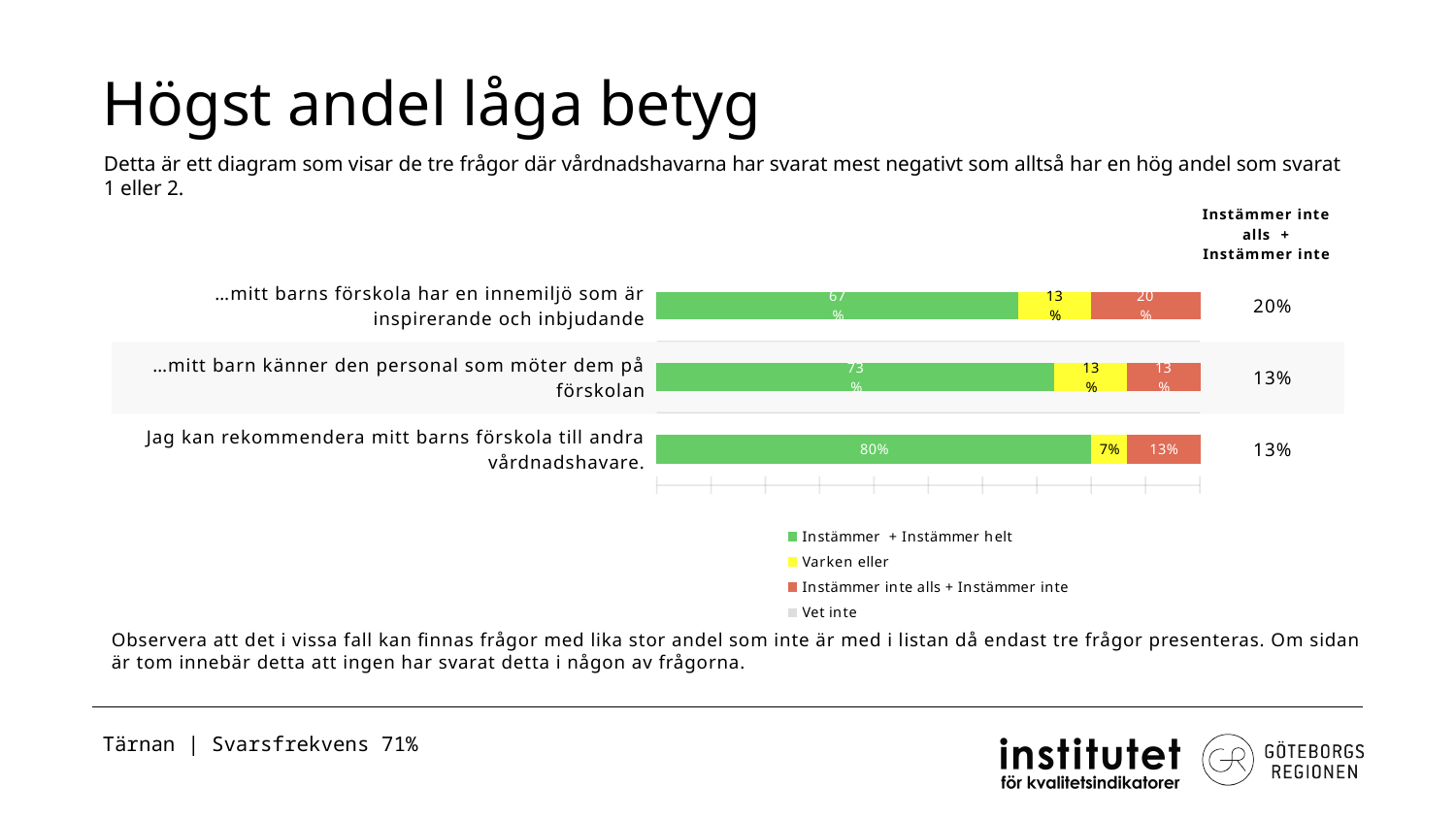
What kind of chart is shown on the slide? Stacked bar chart Which colour represents "Instämmer inte alls + Instämmer inte" in the chart? Red Which question has the highest share of "Instämmer inte alls + Instämmer inte" answers? …mitt barns förskola har en innemiljö som är inspirerande och inbjudande Which question has the lowest share of "Instämmer + Instämmer helt" answers? …mitt barns förskola har en innemiljö som är inspirerande och inbjudande What is the difference in the "Instämmer + Instämmer helt" share between "Jag kan rekommendera mitt barns förskola till andra vårdnadshavare" and "…mitt barns förskola har en innemiljö som är inspirerande och inbjudande"? 13 percentage points How many series does the legend list? 4 What share of respondents answered "Varken eller" for "Jag kan rekommendera mitt barns förskola till andra vårdnadshavare"? 7% Which is larger: the "Varken eller" share for "…mitt barn känner den personal som möter dem på förskolan" or for "Jag kan rekommendera mitt barns förskola till andra vårdnadshavare"? …mitt barn känner den personal som möter dem på förskolan What share of respondents answered "Instämmer + Instämmer helt" for "Jag kan rekommendera mitt barns förskola till andra vårdnadshavare"? 80% What share of respondents answered "Instämmer + Instämmer helt" for "…mitt barn känner den personal som möter dem på förskolan"? 73% How many questions (categories) are shown in the chart? 3 What share of respondents answered "Instämmer inte alls + Instämmer inte" for "…mitt barns förskola har en innemiljö som är inspirerande och inbjudande"? 20%